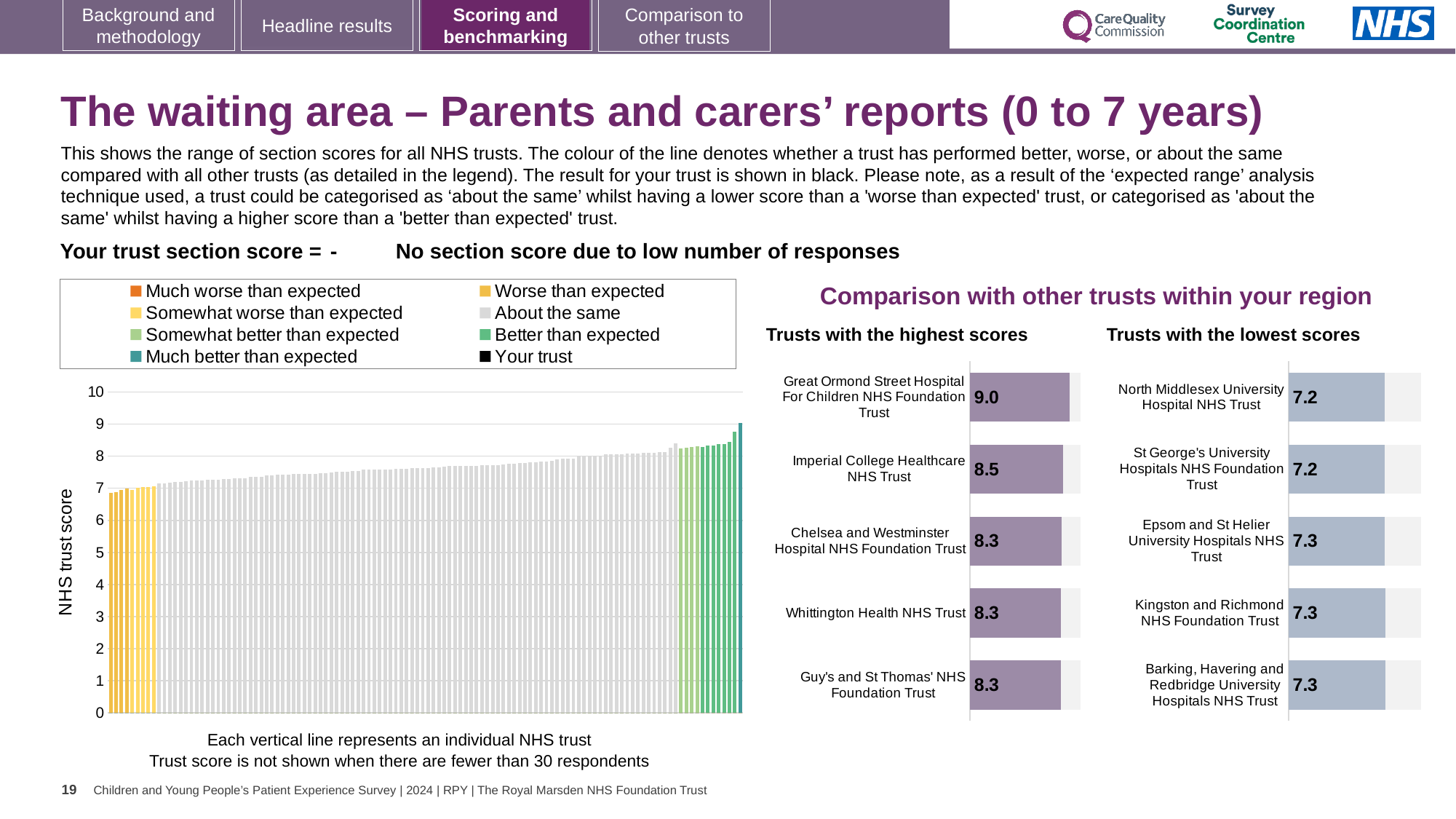
In the 'Trusts with the highest scores' chart, what is the score for Great Ormond Street Hospital For Children NHS Foundation Trust? 9.0 In the 'Trusts with the highest scores' chart, what is the score for Imperial College Healthcare NHS Trust? 8.5 In the 'Trusts with the lowest scores' chart, what is the difference between the scores of Barking, Havering and Redbridge University Hospitals NHS Trust and North Middlesex University Hospital NHS Trust? 0.1 How many trusts are shown in the 'Trusts with the highest scores' chart? 5 In the 'Trusts with the lowest scores' chart, what is the score for Epsom and St Helier University Hospitals NHS Trust? 7.3 In the 'Trusts with the lowest scores' chart, what is the score for North Middlesex University Hospital NHS Trust? 7.2 What kind of chart is the large chart on the left showing NHS trust scores? Bar chart In the 'Trusts with the lowest scores' chart, which has the higher score: Kingston and Richmond NHS Foundation Trust or St George's University Hospitals NHS Foundation Trust? Kingston and Richmond NHS Foundation Trust In the 'Trusts with the highest scores' chart, which trust has the highest score? Great Ormond Street Hospital For Children NHS Foundation Trust In the large chart on the left, do the NHS trust scores rise or fall from left to right? Rise In the 'Trusts with the highest scores' chart, what is the difference between the scores of Great Ormond Street Hospital For Children NHS Foundation Trust and Imperial College Healthcare NHS Trust? 0.5